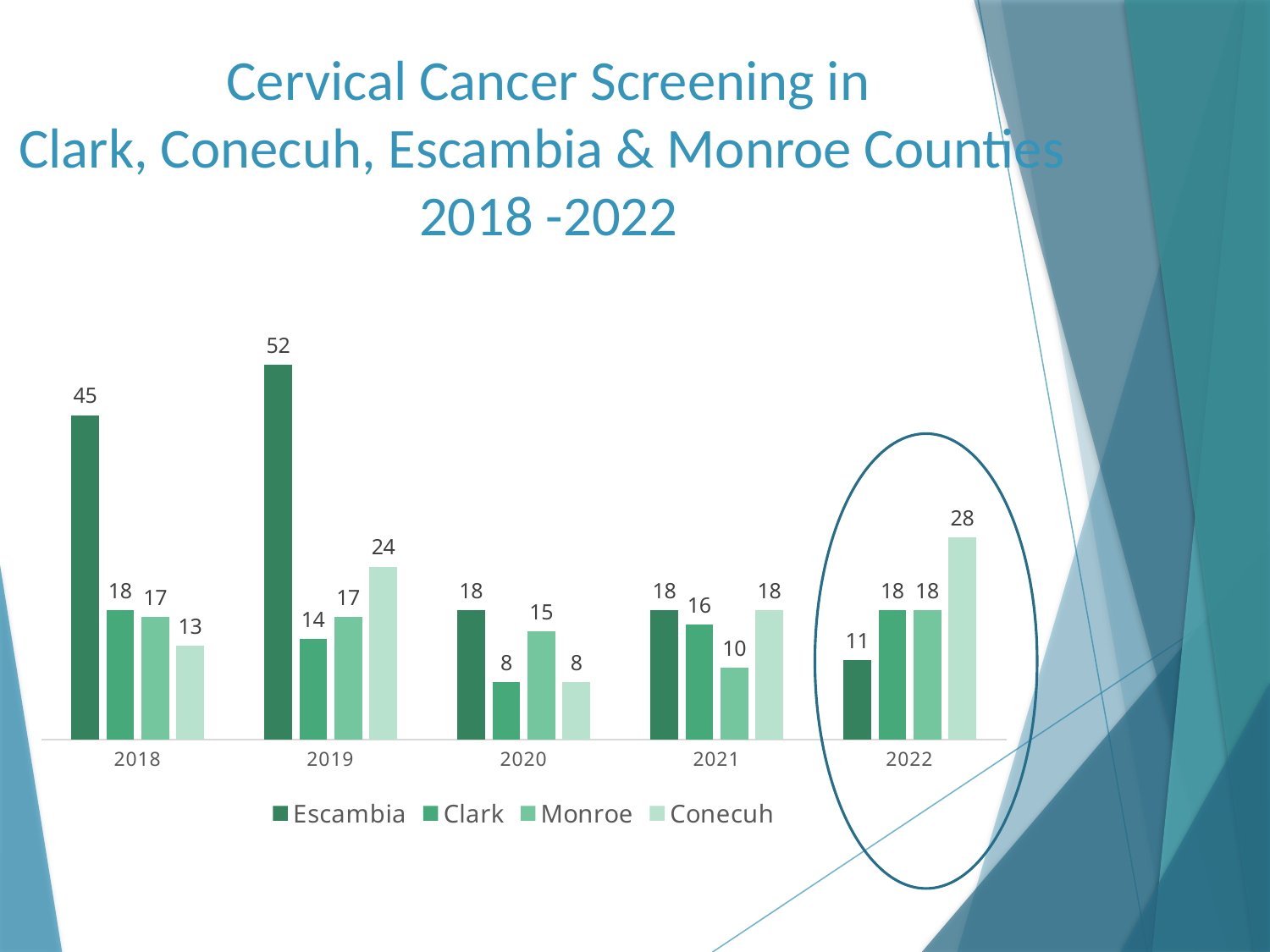
What kind of chart is shown on the slide? Bar chart What is the value for Clark in 2021? 16 Which year on the chart is circled? 2022 What is the difference between the Escambia values in 2019 and 2018? 7 In which year is the Escambia value lowest? 2022 How many series does the legend list? 4 How many years are shown on the x axis? 5 What is the value for Monroe in 2020? 15 Which is larger, the Conecuh value in 2022 or the Conecuh value in 2019? Conecuh in 2022 What is the value for Escambia in 2019? 52 In which year is the Escambia value highest? 2019 What is the value for Conecuh in 2022? 28